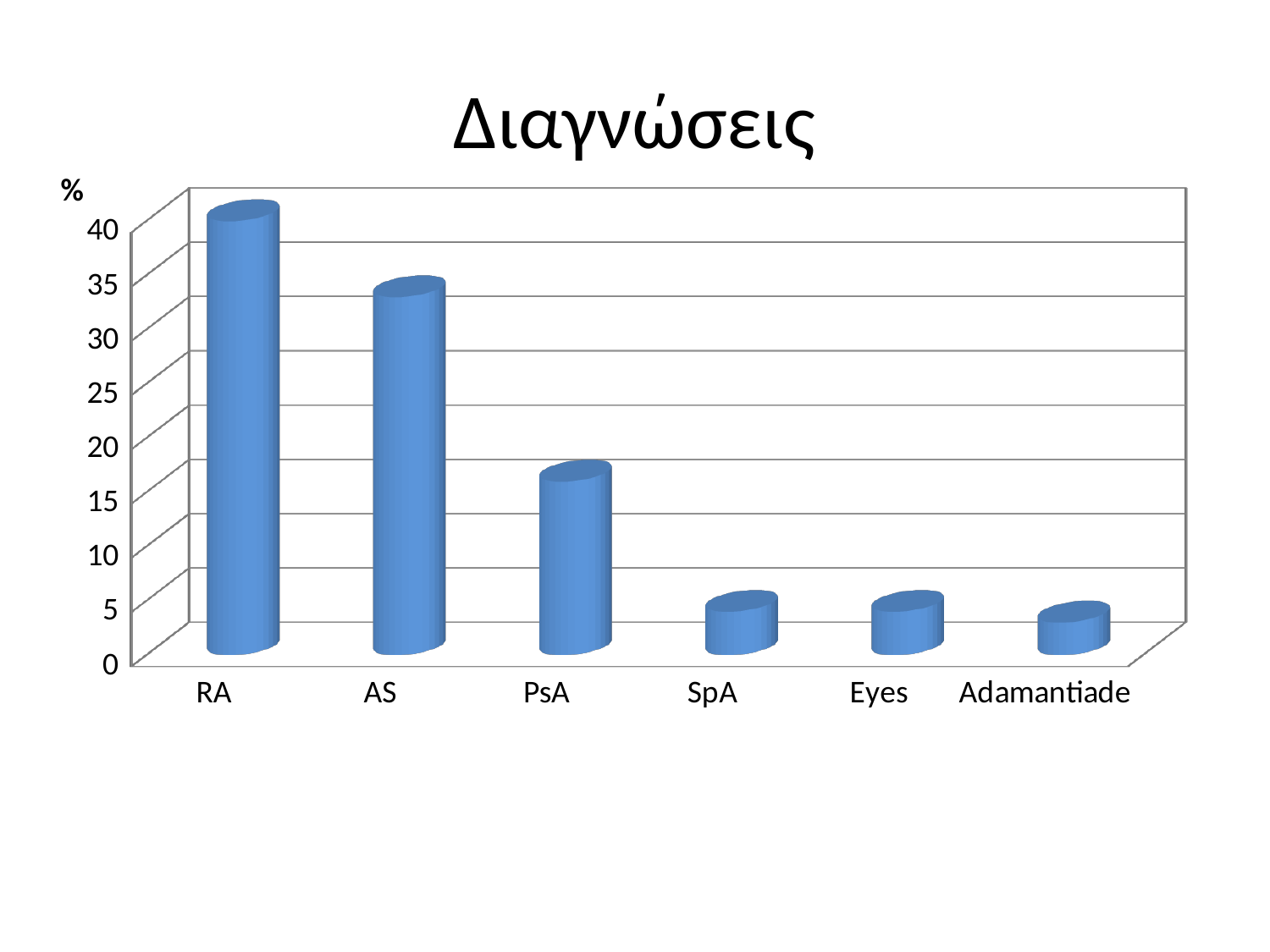
How many categories are shown on the x axis of the chart? 6 Is the value for AS greater or less than 30? greater Which is larger, the value for AS or the value for PsA? AS Is the value for Adamantiade greater or less than 10? less Is the value for RA greater or less than 35? greater Which category has the highest value in the chart? RA Do the values rise or fall moving from left to right along the x axis? fall What unit label is shown at the top of the vertical axis? % What kind of chart is shown on the slide? bar chart What is the title of the chart? Διαγνώσεις